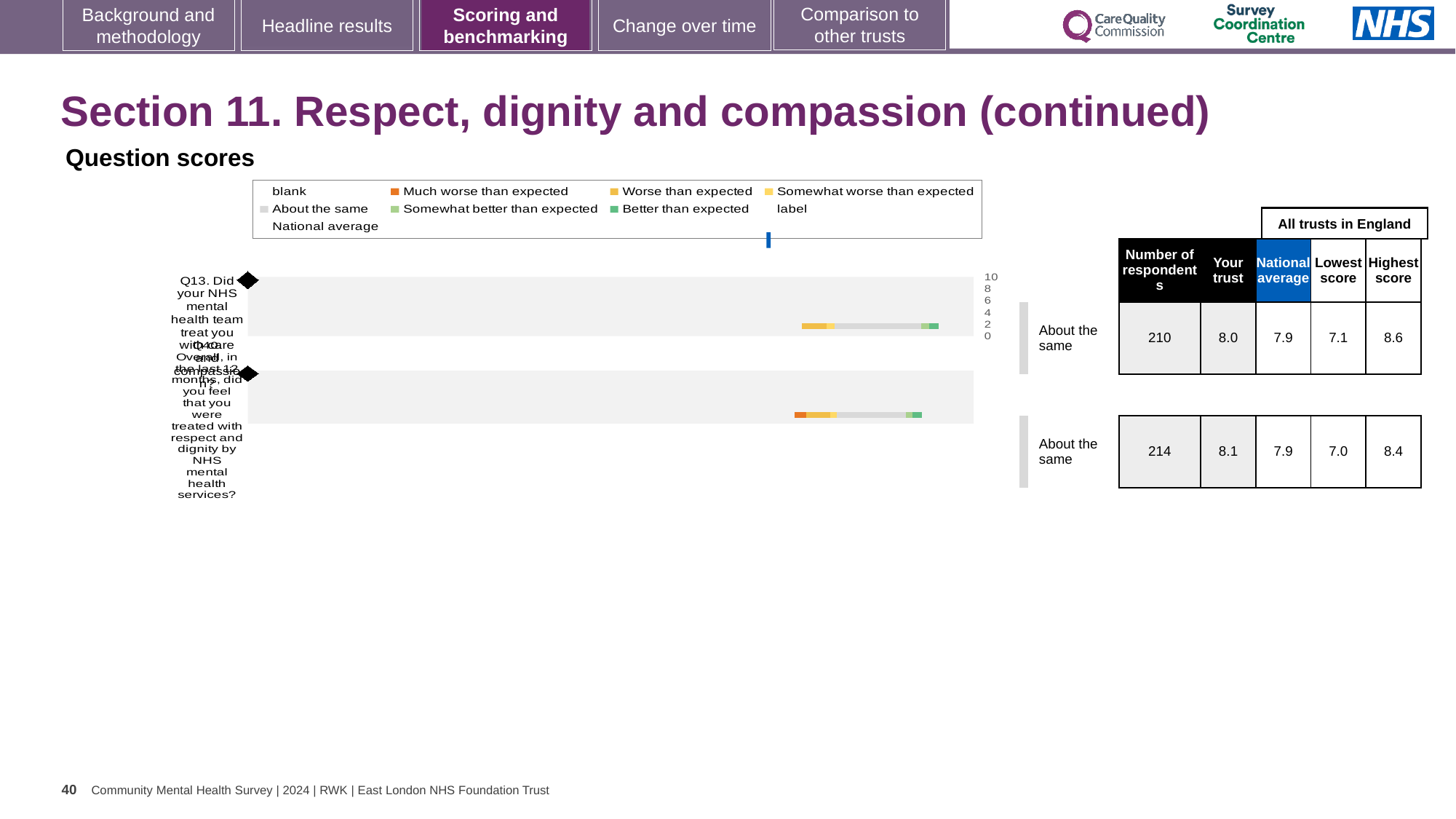
What is the 'Your trust' score for Q13 (care and compassion)? 8.0 What kind of chart is used to show the question scores on this slide? bar chart How many questions are plotted in the question scores chart? 2 What is the highest score among all trusts in England for Q14 (respect and dignity)? 8.4 What benchmark category is shown for Q13 (care and compassion)? About the same What is the difference between the highest and lowest scores for Q13 (care and compassion)? 1.5 What is the lowest score among all trusts in England for Q13 (care and compassion)? 7.1 Which question has the higher 'Your trust' score, Q13 or Q14? Q14 What is the national average score for Q14 (respect and dignity)? 7.9 By how much does the trust's score for Q14 exceed the national average? 0.2 Which legend entry is represented by the dark orange colour in the chart? Much worse than expected What is the number of respondents for Q13 (care and compassion)? 210